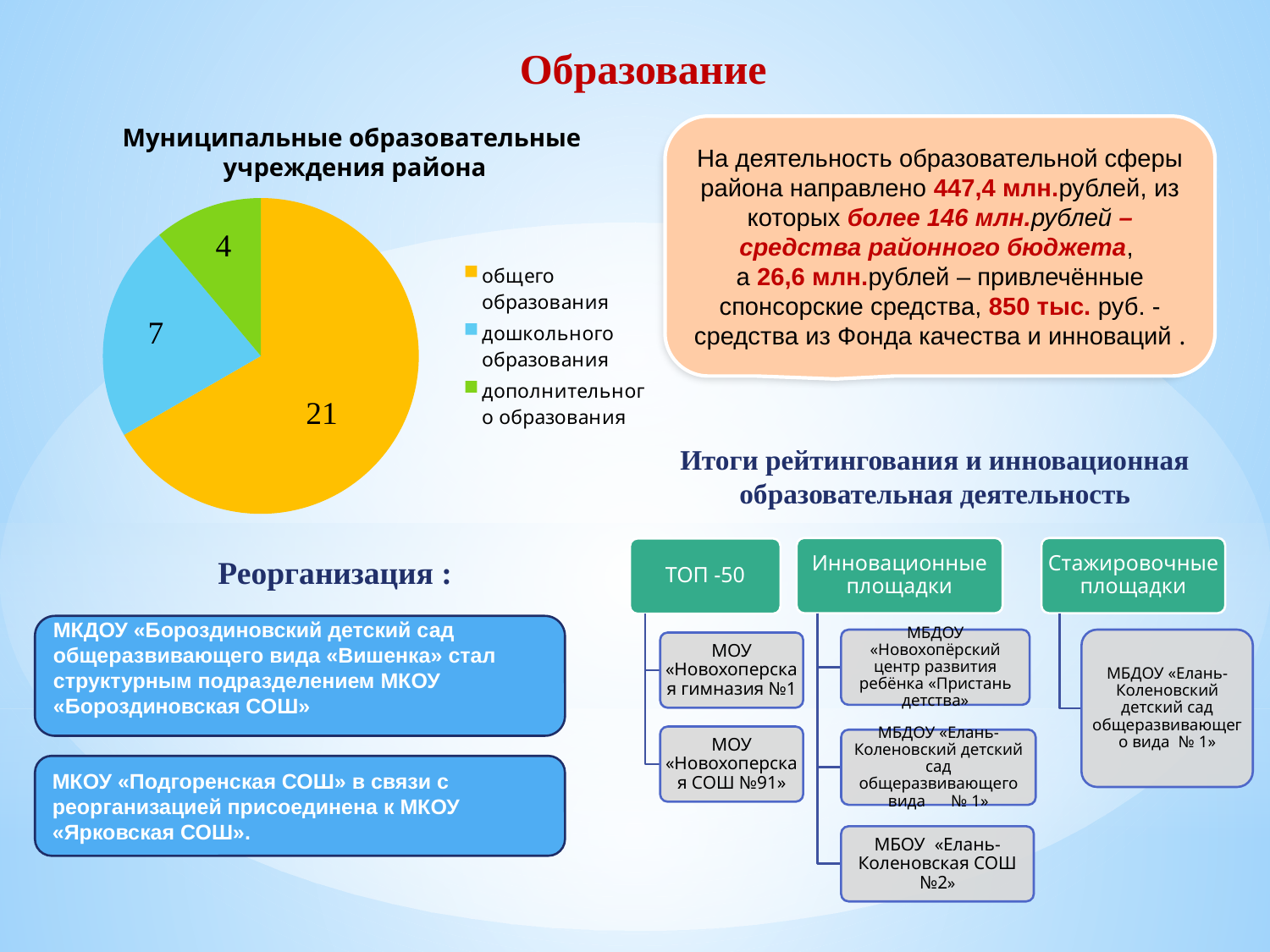
Which category has the largest slice in the pie chart? общего образования What is the value for «общего образования» in the pie chart? 21 What colour is the slice for «общего образования» in the pie chart? yellow What is the difference between the values for «общего образования» and «дошкольного образования» in the pie chart? 14 What is the value for «дополнительного образования» in the pie chart? 4 How many categories does the pie chart show? 3 What is the value for «дошкольного образования» in the pie chart? 7 Which category has the smallest slice in the pie chart? дополнительного образования What is the difference between the values for «дошкольного образования» and «дополнительного образования» in the pie chart? 3 What kind of chart is shown under the title «Муниципальные образовательные учреждения района»? pie chart Which is larger in the pie chart: «дошкольного образования» or «дополнительного образования»? дошкольного образования What is the total of all slices in the pie chart? 32